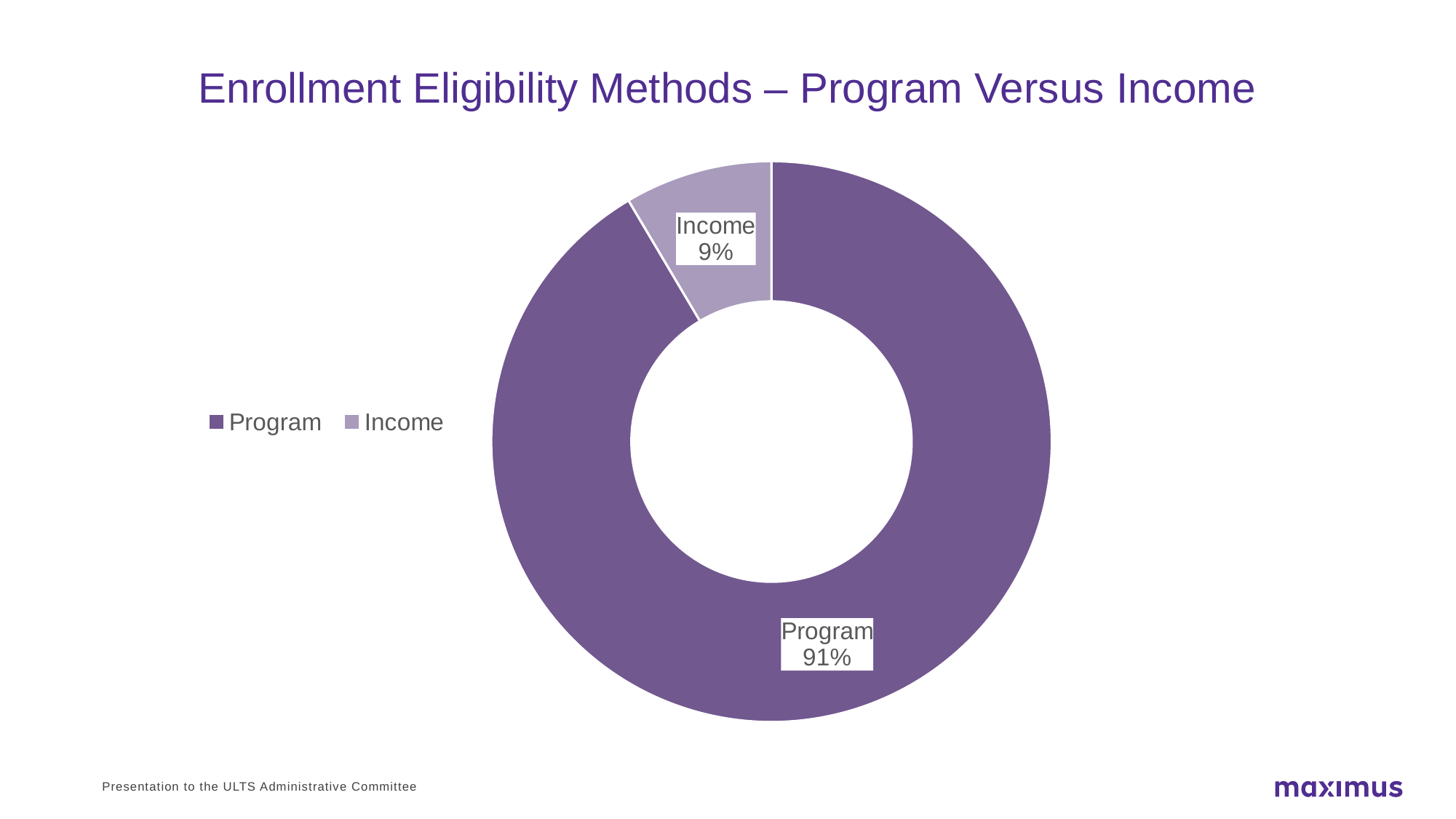
Which is larger, the Program share or the Income share? Program What share of enrollment eligibility is by Income? 9% Which eligibility method has the largest share? Program What is the difference in percentage points between the Program and Income shares? 82 Which category is shown in the lighter purple colour? Income How many entries does the legend list? 2 What kind of chart is shown on the slide? Pie chart (doughnut) What is the title of the chart on the slide? Enrollment Eligibility Methods – Program Versus Income Which eligibility method has the smallest share? Income Is the Income share greater or less than 10%? less What share of enrollment eligibility is by Program? 91% How many categories are shown in the chart? 2